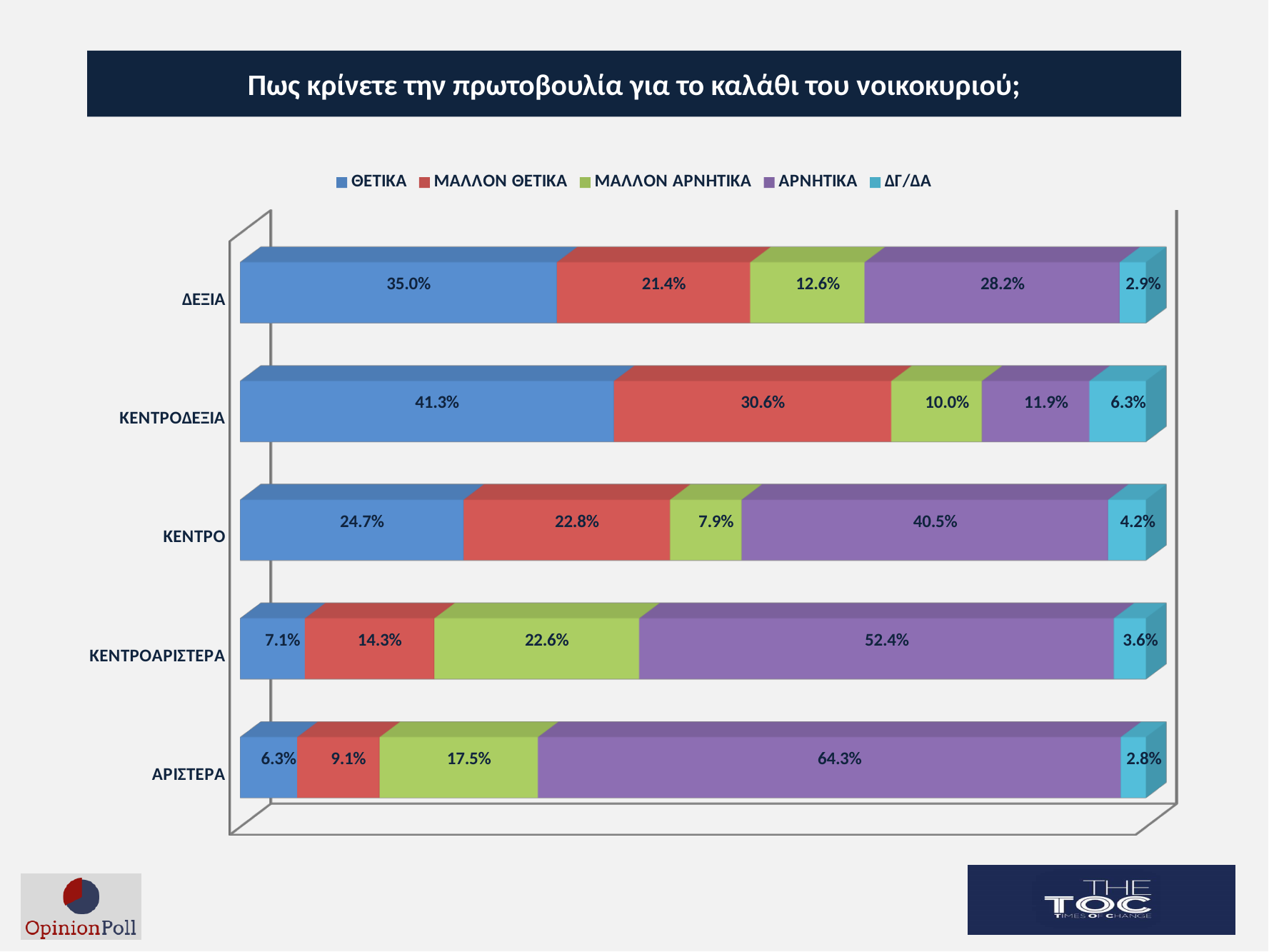
Which category has the highest ΘΕΤΙΚΑ value? ΚΕΝΤΡΟΔΕΞΙΑ How many categories are shown on the chart? 5 Which category has the highest ΑΡΝΗΤΙΚΑ value? ΑΡΙΣΤΕΡΑ What is the difference between the ΑΡΝΗΤΙΚΑ values for ΚΕΝΤΡΟ and ΔΕΞΙΑ? 12.3 percentage points Which is larger, the ΜΑΛΛΟΝ ΘΕΤΙΚΑ value for ΔΕΞΙΑ or for ΚΕΝΤΡΟ? ΚΕΝΤΡΟ What is the combined ΘΕΤΙΚΑ and ΜΑΛΛΟΝ ΘΕΤΙΚΑ value for ΚΕΝΤΡΟΔΕΞΙΑ? 71.9% What kind of chart is shown on the slide? Stacked bar chart How many series does the legend list? 5 What is the ΘΕΤΙΚΑ value for ΚΕΝΤΡΟΔΕΞΙΑ? 41.3% What is the ΑΡΝΗΤΙΚΑ value for ΑΡΙΣΤΕΡΑ? 64.3% What is the ΔΓ/ΔΑ value for ΚΕΝΤΡΟ? 4.2% Which category has the lowest ΘΕΤΙΚΑ value? ΑΡΙΣΤΕΡΑ